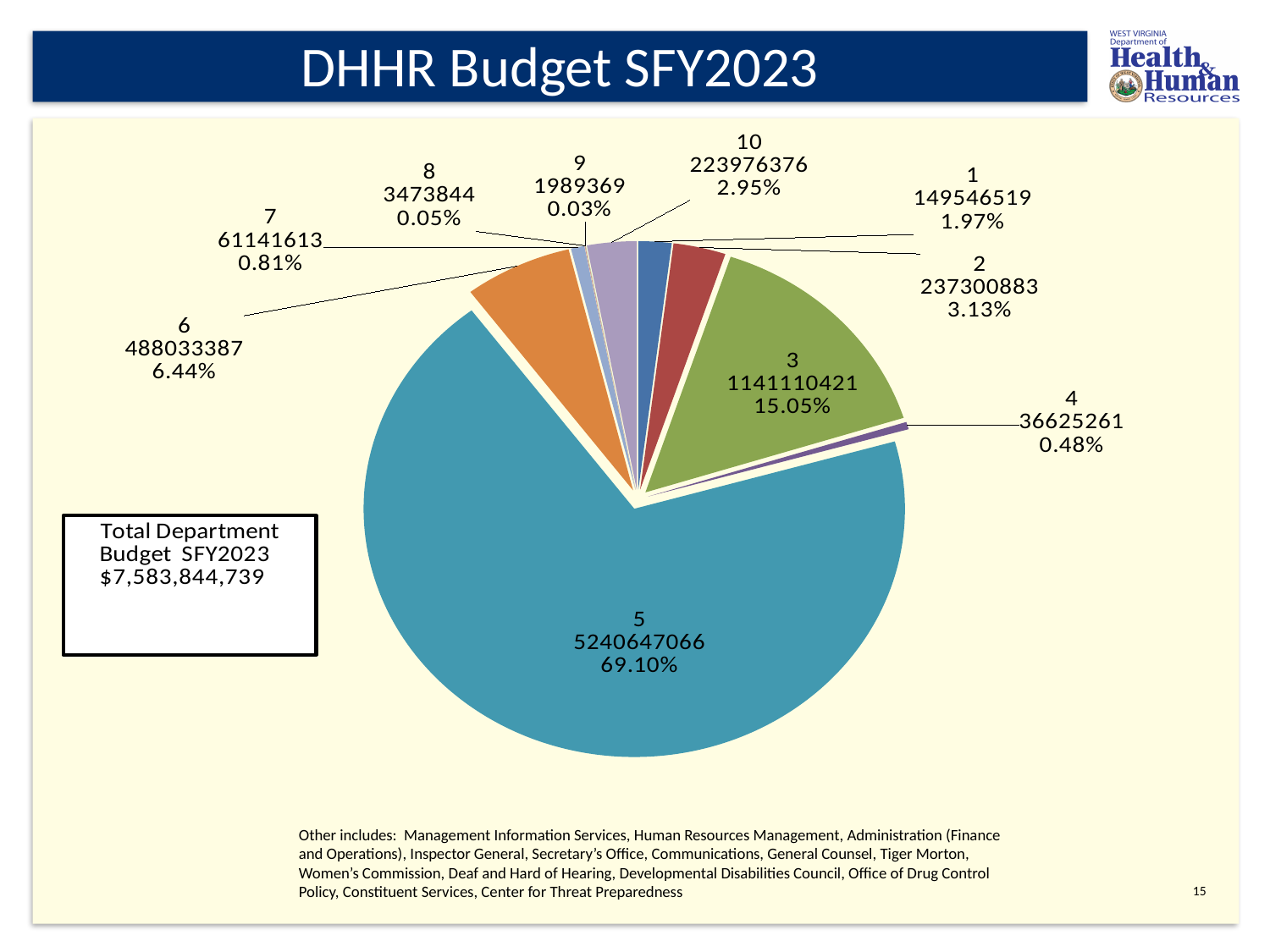
What kind of chart is shown on the slide? Pie chart Which is larger, the value for slice 2 or the value for slice 1? Slice 2 What is the difference between the values for slice 2 and slice 1? 87754364 What percentage share does slice 3 have in the pie chart? 15.05% What percentage share does slice 10 have? 2.95% Which slice has the largest share of the pie? 5 What is the difference between the values for slice 6 and slice 10? 264057011 What is the value shown for slice 6? 488033387 Which slice has the smallest share of the pie? 9 What is the value shown for slice 5 in the pie chart? 5240647066 How many slices does the pie chart have? 10 What is the title of the slide containing the pie chart? DHHR Budget SFY2023